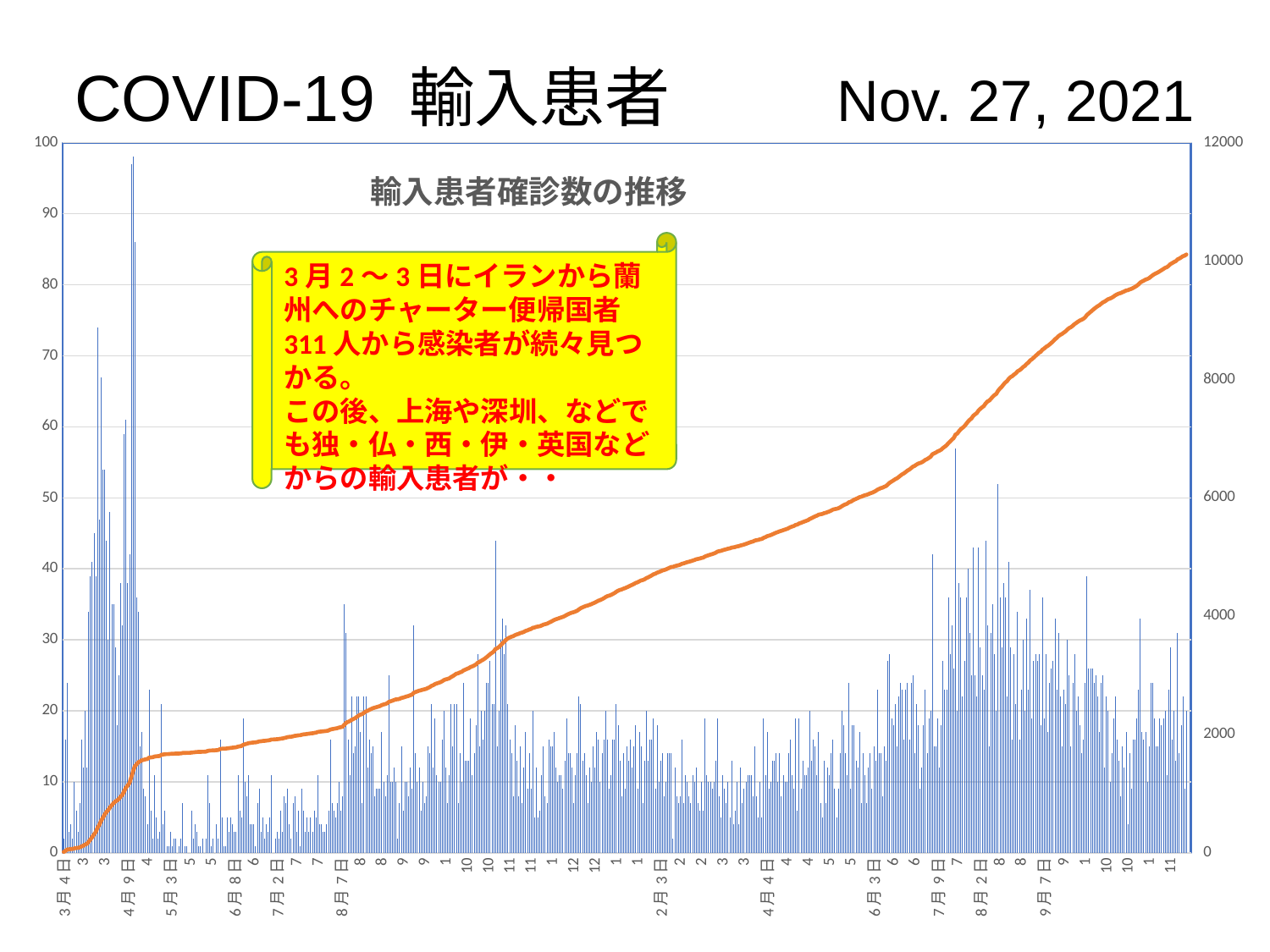
Is the value of the orange line at 2月3日 greater or less than 6000 on the right axis? less What is the maximum value shown on the right vertical axis? 12000 Which is larger: the tallest bar near 4月9日 or the tallest bar near 7月9日 (second year)? The bar near 4月9日 What is the maximum value shown on the left vertical axis? 100 What kind of chart is shown on the slide? A combination of a bar chart and a line chart Does the orange line rise or fall from left to right along the x axis? Rises Is the value of the orange line at 9月7日 (second year) greater or less than 8000 on the right axis? greater What is the first date label shown on the x axis? 3月4日 Is the tallest bar in the chart (near 4月9日) greater or less than 90 on the left axis? greater